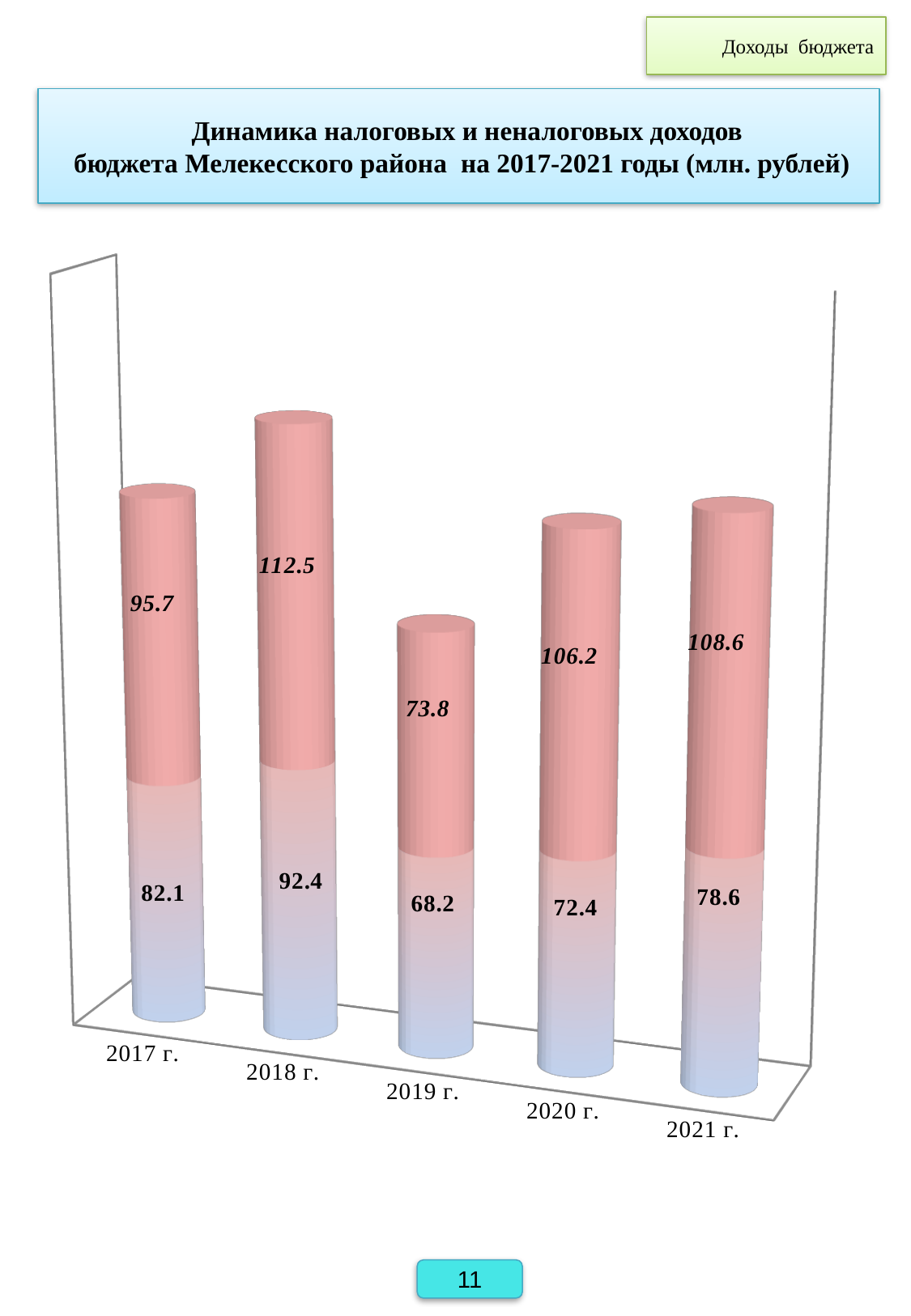
How many years are shown on the x axis? 5 What is the value of the blue (lower) segment for 2019 г.? 68.2 What is the value of the pink (upper) segment for 2021 г.? 108.6 What is the total of the stacked bar for 2017 г.? 177.8 What is the difference between the pink (upper) segment values for 2018 г. and 2019 г.? 38.7 What kind of chart is shown on the slide? Stacked bar chart Does the blue (lower) segment rise or fall from 2019 г. to 2021 г.? Rise Which year has the highest value for the blue (lower) segment? 2018 г. What unit is given in the chart title? млн. рублей What is the value of the pink (upper) segment for 2018 г.? 112.5 Which is larger: the blue (lower) segment for 2020 г. or for 2021 г.? 2021 г. Which year has the lowest value for the pink (upper) segment? 2019 г.